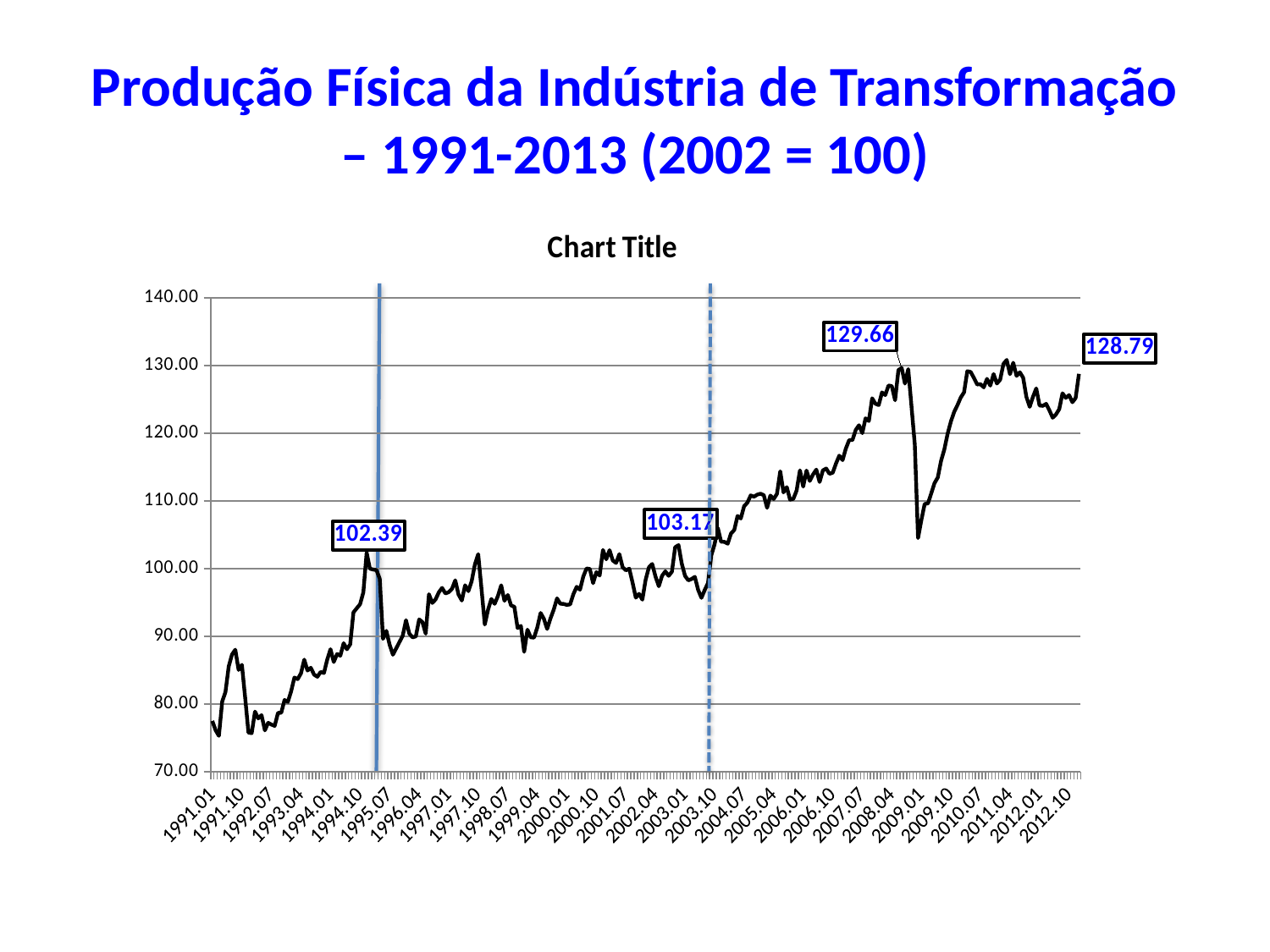
What is the highest value labeled on the chart? 129.66 Which is larger, the labeled value near the dashed vertical line or the labeled value near the solid vertical line? the value near the dashed line (103.17) What kind of chart is shown on the slide? line chart What value is labeled next to the dashed vertical line near 2003.10? 103.17 What value is labeled at the final point of the series, at the right end of the line? 128.79 Is the value at 1991.01 greater or less than 80.00? less What is the title printed above the chart? Chart Title What is the lowest value labeled on the chart? 102.39 What value is labeled next to the solid vertical line near 1995? 102.39 Does the series generally rise or fall from 1991 to 2013? rise Is the value at the trough around 2009.01 greater or less than 100.00? greater What is the difference between the labeled values 129.66 and 128.79? 0.87